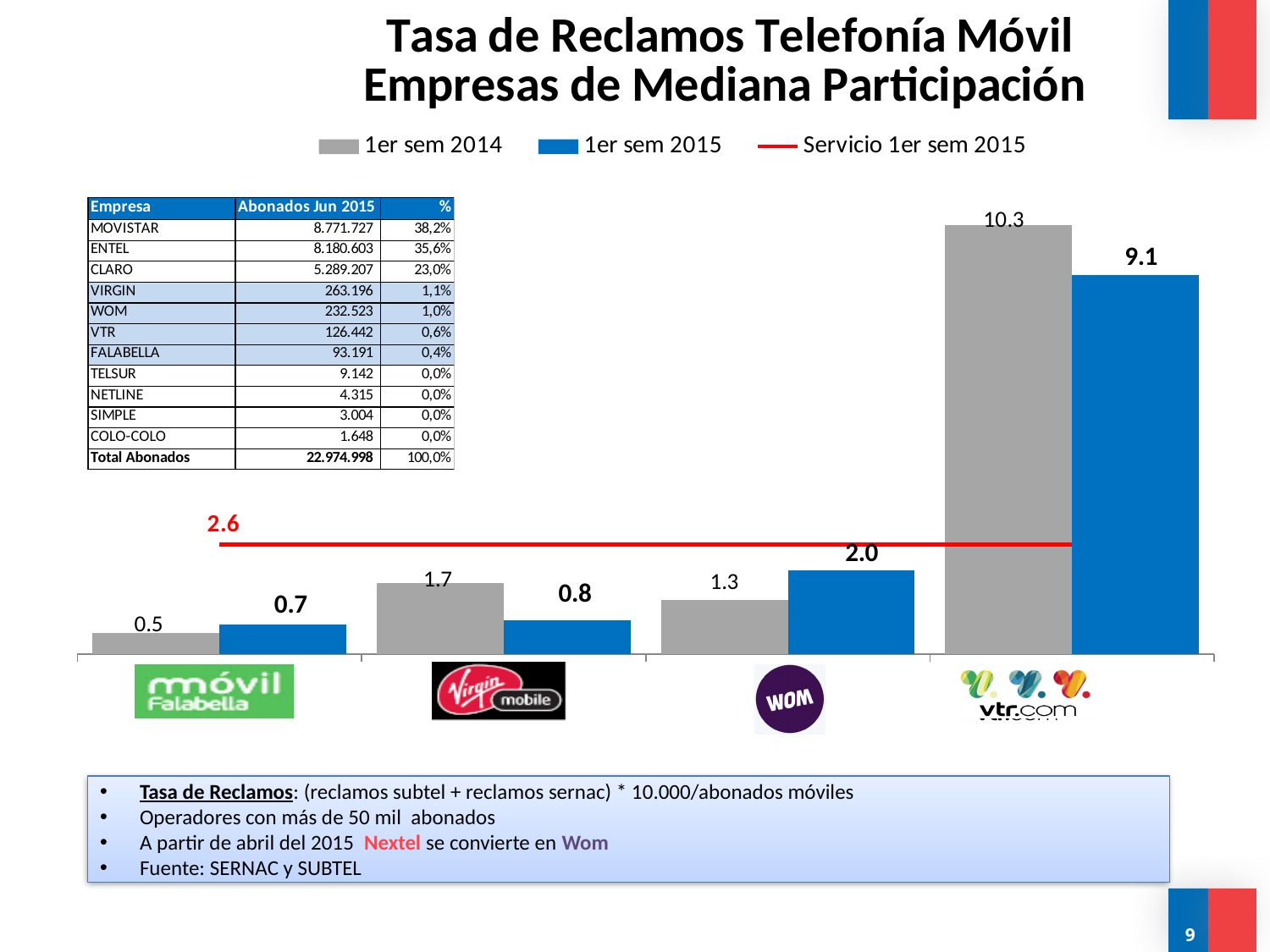
For Virgin Mobile, which is larger: the 1er sem 2014 value or the 1er sem 2015 value? 1er sem 2014 What is the difference between the 1er sem 2014 and 1er sem 2015 values for VTR? 1.2 What type of chart is shown on the slide? combination bar and line chart Which series is shown in blue in the chart legend? 1er sem 2015 What value does the red 'Servicio 1er sem 2015' line show? 2.6 What is the 1er sem 2015 value for VTR? 9.1 What is the 1er sem 2015 value for WOM? 2.0 How many series does the chart legend list? 3 How many companies are shown on the x axis of the chart? 4 What is the 1er sem 2014 value for Virgin Mobile? 1.7 Which company has the lowest 1er sem 2015 value? Móvil Falabella Which company has the highest 1er sem 2014 value? VTR